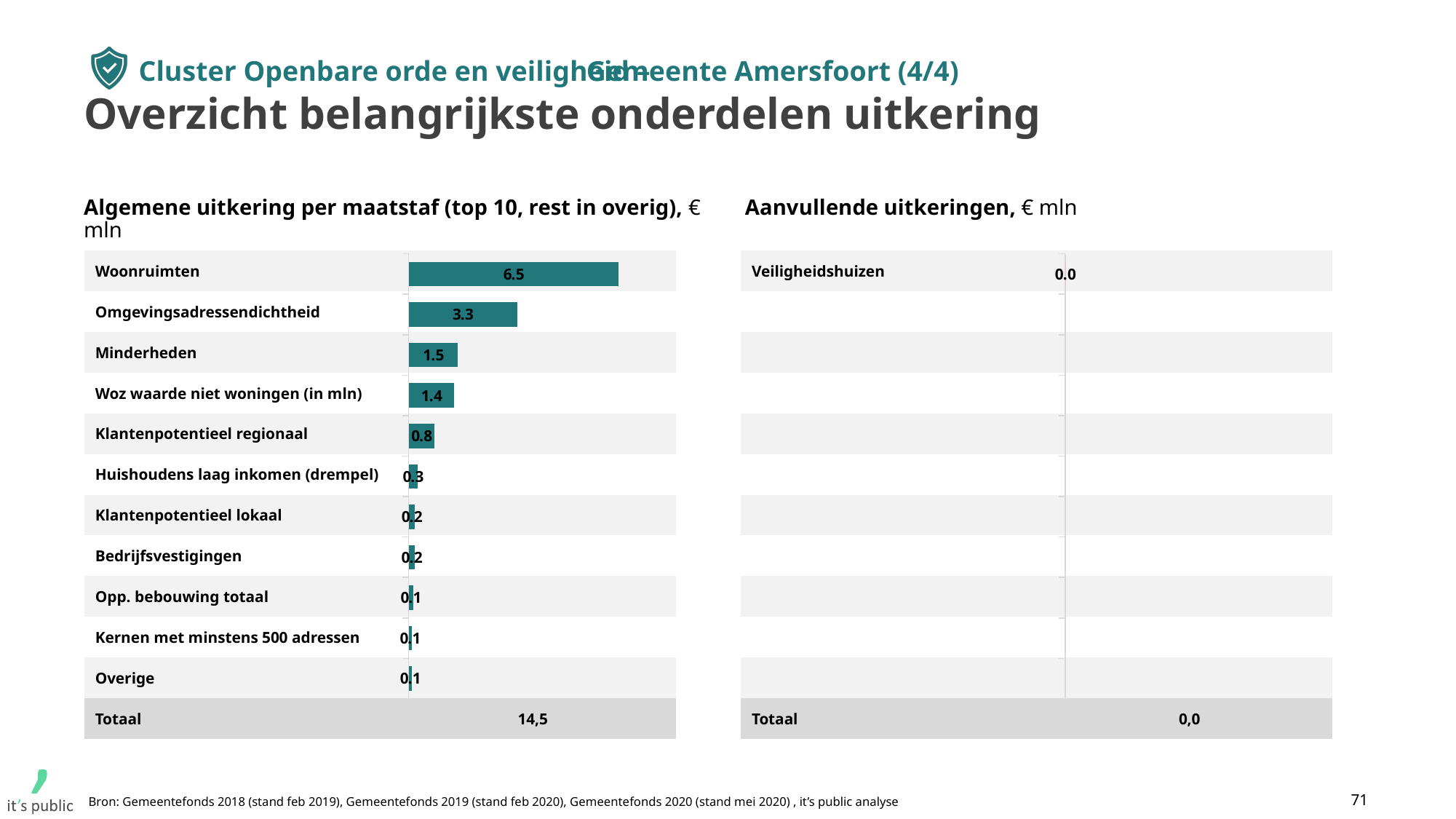
In what unit are the values in the 'Algemene uitkering per maatstaf' chart expressed? € mln What kind of chart is the 'Algemene uitkering per maatstaf' chart? Bar chart In the 'Algemene uitkering per maatstaf' chart, what is the value for Omgevingsadressendichtheid? 3.3 What is the Totaal shown under the 'Aanvullende uitkeringen' chart? 0,0 How many categories are shown in the 'Algemene uitkering per maatstaf' chart (excluding the Totaal row)? 11 In the 'Algemene uitkering per maatstaf' chart, which is larger: Minderheden or Klantenpotentieel regionaal? Minderheden In the 'Algemene uitkering per maatstaf' chart, which category has the highest value? Woonruimten In the 'Algemene uitkering per maatstaf' chart, what is the difference between Woonruimten and Omgevingsadressendichtheid? 3.2 In the 'Algemene uitkering per maatstaf' chart, what is the value for Klantenpotentieel regionaal? 0.8 What is the Totaal shown under the 'Algemene uitkering per maatstaf' chart? 14,5 In the 'Aanvullende uitkeringen' chart, what is the value for Veiligheidshuizen? 0.0 In the 'Algemene uitkering per maatstaf' chart, what is the value for Woonruimten? 6.5